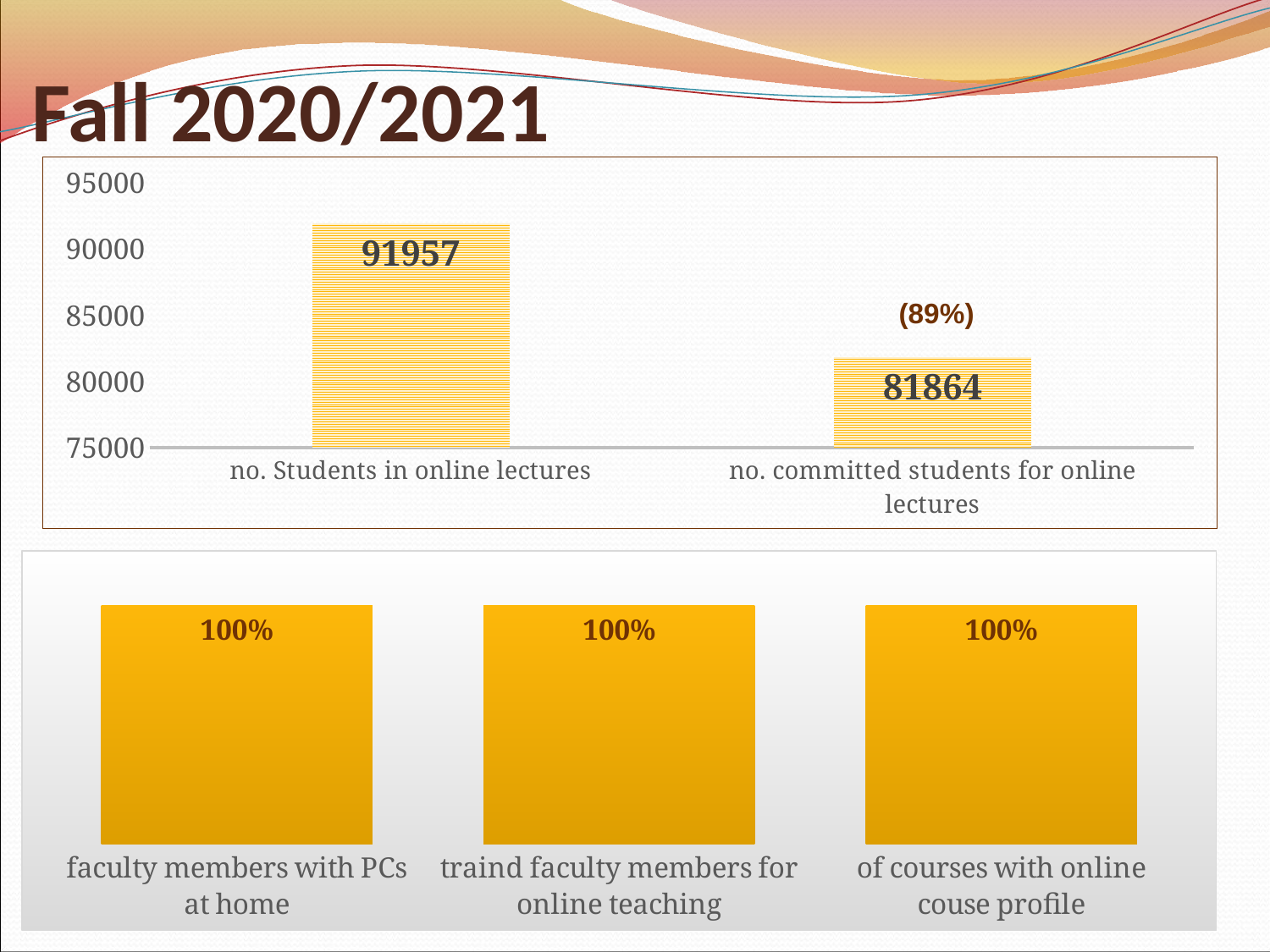
What kind of chart is the top chart? bar chart In the top chart, how many categories are shown? 2 In the top chart, which category has the higher value? no. Students in online lectures In the top chart, is the value for no. committed students for online lectures greater or less than 85000? less In the top chart, what is the difference between no. Students in online lectures and no. committed students for online lectures? 10093 In the bottom chart, what is the value for faculty members with PCs at home? 100% In the top chart, what percentage is printed above the no. committed students for online lectures bar? (89%) In the top chart, which category has the lower value? no. committed students for online lectures In the top chart, what is the value for no. Students in online lectures? 91957 In the top chart, what is the value for no. committed students for online lectures? 81864 In the bottom chart, how many categories are shown? 3 In the bottom chart, what is the value for of courses with online couse profile? 100%